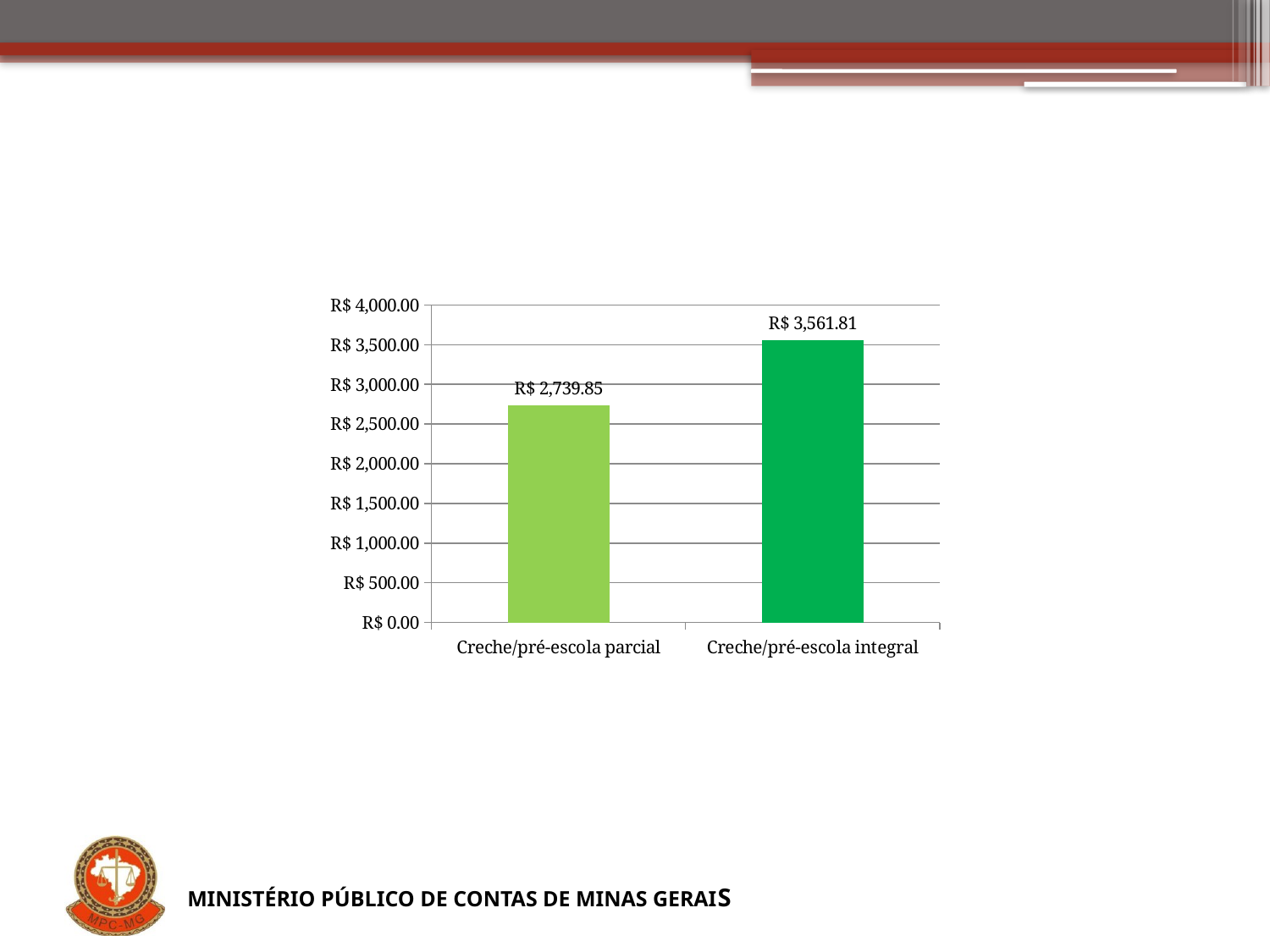
Which category has the highest value? Creche/pré-escola integral What is the highest value shown on the vertical axis? R$ 4,000.00 What is the value for Creche/pré-escola parcial? R$ 2,739.85 Which is larger, the value for Creche/pré-escola parcial or the value for Creche/pré-escola integral? Creche/pré-escola integral What kind of chart is shown on the slide? bar chart Do the values rise or fall from left to right along the x axis? rise Which category has the lowest value? Creche/pré-escola parcial How many categories are shown on the chart? 2 What is the value for Creche/pré-escola integral? R$ 3,561.81 Is the value for Creche/pré-escola parcial greater or less than R$ 3,000.00? less Is the value for Creche/pré-escola integral greater or less than R$ 3,500.00? greater What is the difference between the values for Creche/pré-escola integral and Creche/pré-escola parcial? R$ 821.96